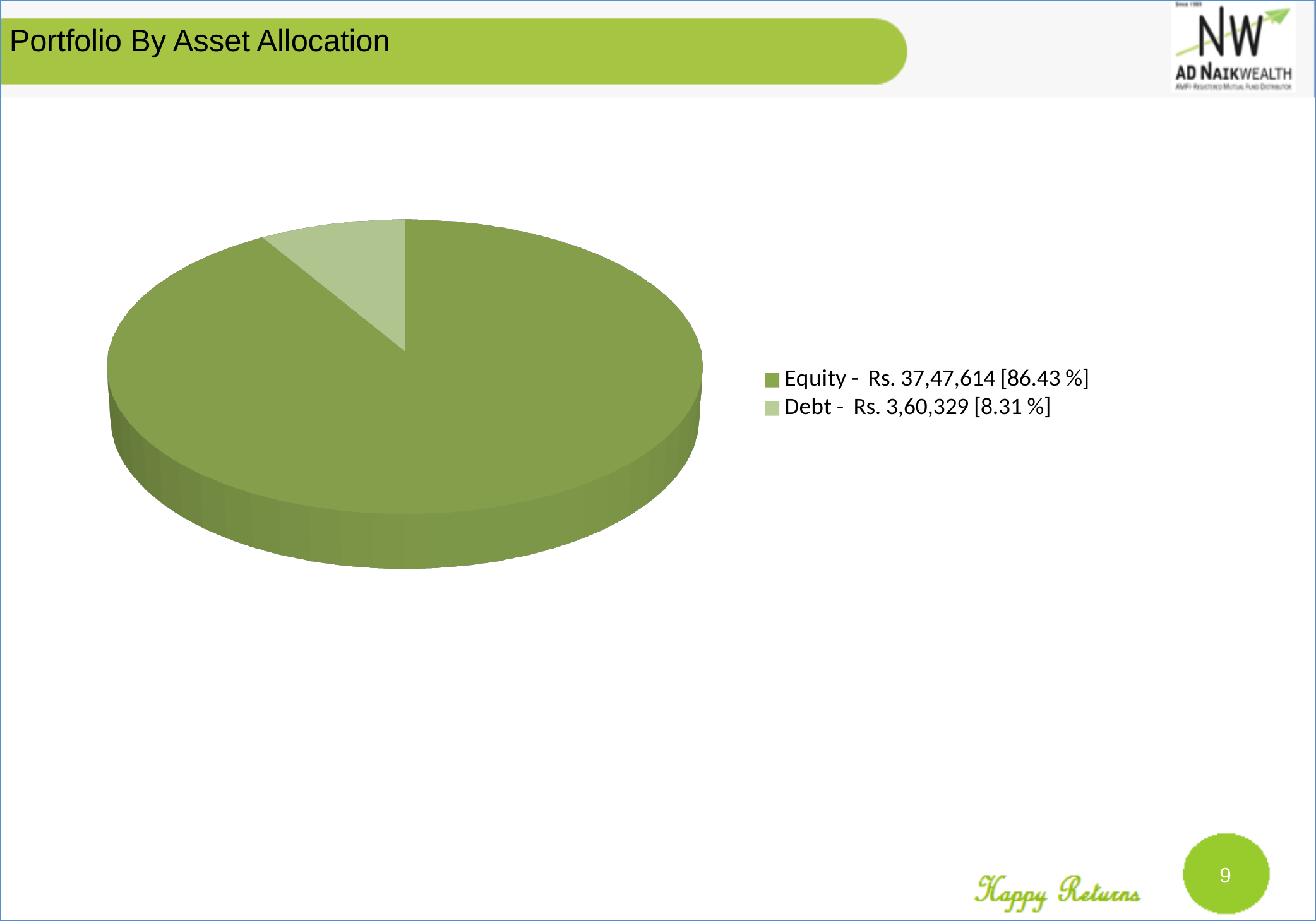
Which category has the smallest slice in the pie chart? Debt What is the difference between the Equity value and the Debt value? Rs. 33,87,285 Which category is shown in the lighter green colour in the pie chart? Debt What is the value for Debt in the pie chart? Rs. 3,60,329 What share of the pie does Debt represent? 8.31 % What is the value for Equity in the pie chart? Rs. 37,47,614 What type of chart is shown on the slide? Pie chart What share of the pie does Equity represent? 86.43 % Which category has the largest slice in the pie chart? Equity Which is larger, the value for Equity or the value for Debt? Equity How many categories are shown in the pie chart? 2 What is the title of the slide containing the pie chart? Portfolio By Asset Allocation